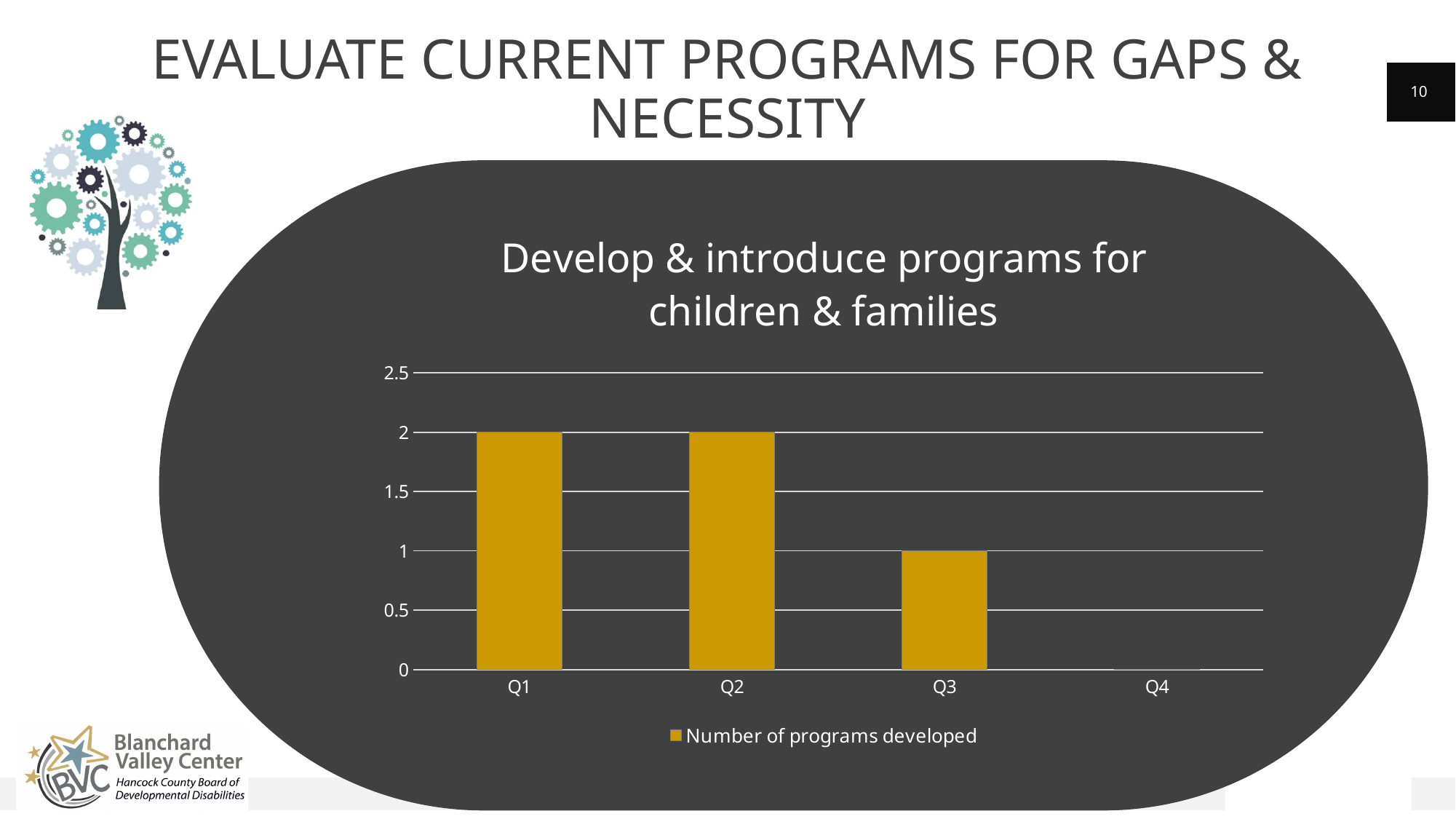
How many quarters are shown on the x axis of the chart? 4 What is the number of programs developed in Q3? 1 What is the number of programs developed in Q4? 0 Which quarter has the lowest number of programs developed? Q4 What is the number of programs developed in Q1? 2 How many series does the chart legend list? 1 What is the difference between the number of programs developed in Q1 and in Q3? 1 Do the values rise or fall from Q2 to Q4? Fall What is the title of the chart? Develop & introduce programs for children & families What kind of chart is shown on the slide? Bar chart Which is larger, the number of programs developed in Q2 or in Q3? Q2 Is the value for Q3 greater or less than 1.5? less